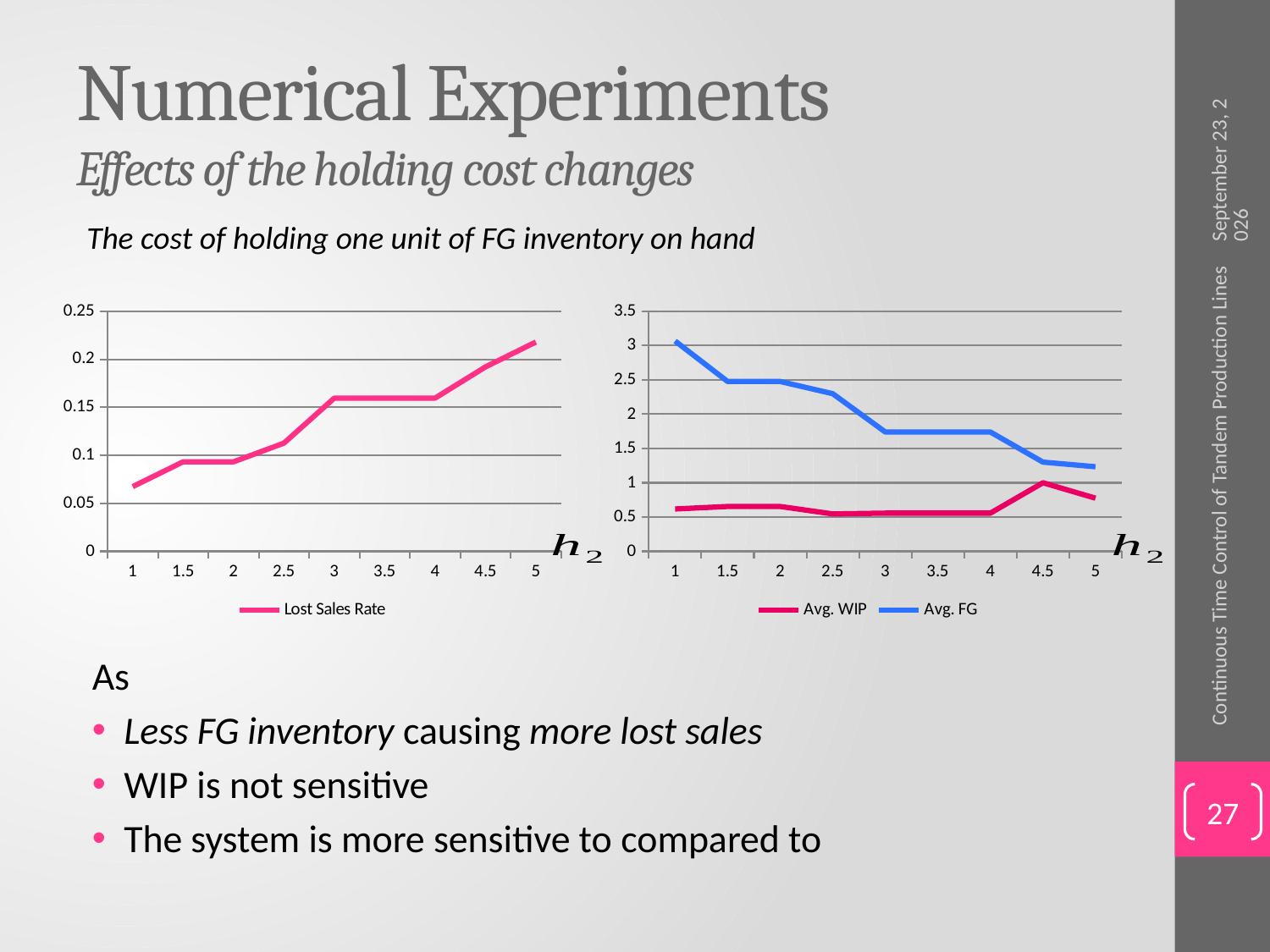
Which series does the legend of the left chart list? Lost Sales Rate In the left chart, is the Lost Sales Rate at h2 = 5 greater or less than 0.2? greater In the right chart, does Avg. FG rise or fall as h2 increases? fall In the right chart, which series is larger at h2 = 1, Avg. WIP or Avg. FG? Avg. FG What kind of chart is the left chart (Lost Sales Rate)? line chart In the left chart, is the Lost Sales Rate at h2 = 1 greater or less than 0.1? less How many h2 values are plotted on the x axis of the left chart? 9 In the left chart, at which h2 value is the Lost Sales Rate lowest? 1 In the left chart, does the Lost Sales Rate rise or fall as h2 increases? rise How many series does the legend of the right chart list? 2 In the left chart, at which h2 value is the Lost Sales Rate highest? 5